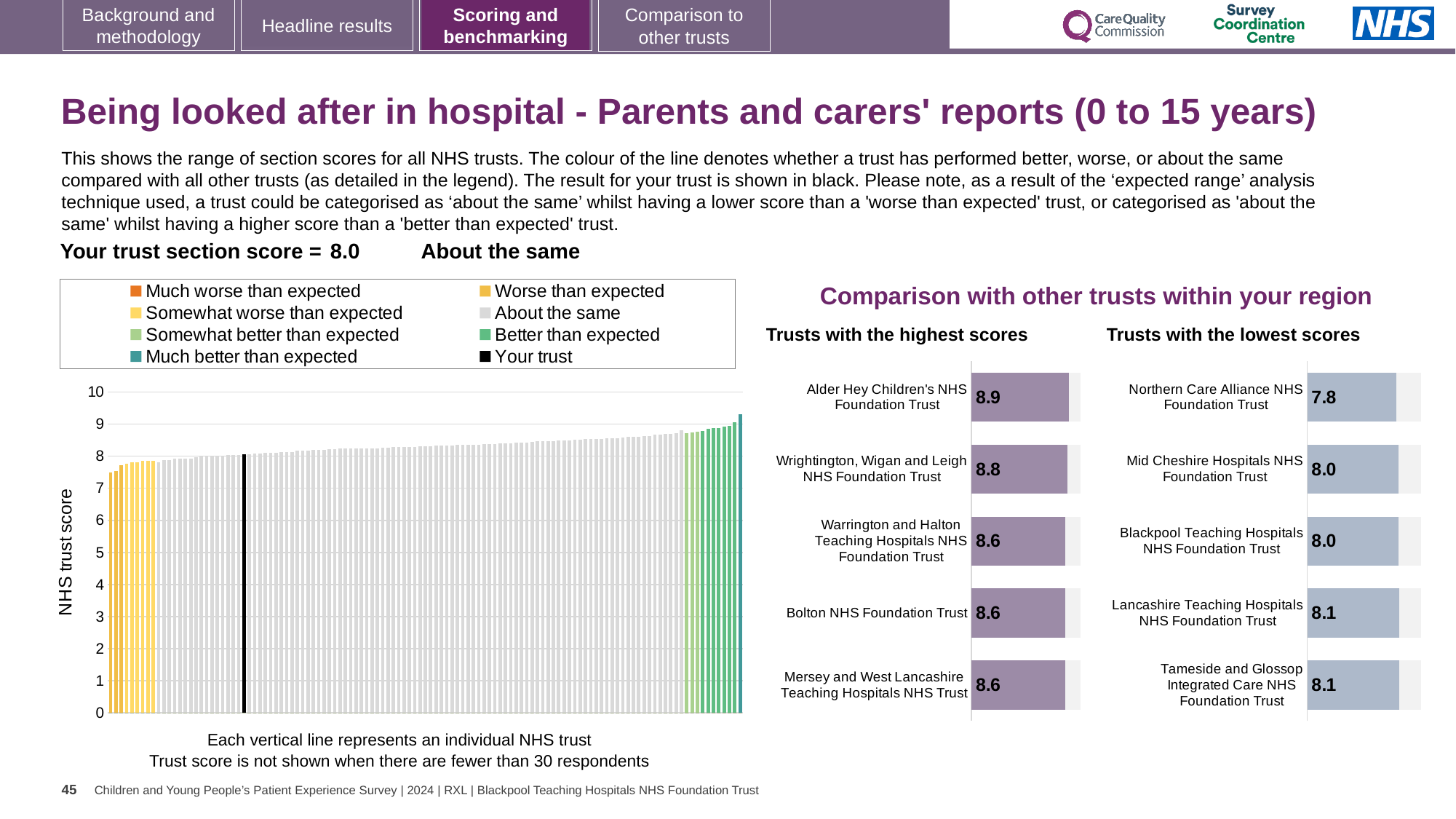
In the 'Trusts with the highest scores' chart, what is the difference between the scores of Alder Hey Children's NHS Foundation Trust and Bolton NHS Foundation Trust? 0.3 In the 'Trusts with the highest scores' chart, which trust has the highest score? Alder Hey Children's NHS Foundation Trust In the 'Trusts with the lowest scores' chart, what is the difference between the scores of Tameside and Glossop Integrated Care NHS Foundation Trust and Northern Care Alliance NHS Foundation Trust? 0.3 In the 'Trusts with the highest scores' chart, what is the score for Alder Hey Children's NHS Foundation Trust? 8.9 What kind of chart is the large chart on the left showing NHS trust scores? Bar chart In the large chart on the left, do the trust scores rise or fall from left to right? Rise How many trusts are shown in the 'Trusts with the highest scores' chart? 5 In the 'Trusts with the lowest scores' chart, what is the score for Northern Care Alliance NHS Foundation Trust? 7.8 In the 'Trusts with the lowest scores' chart, what is the score for Lancashire Teaching Hospitals NHS Foundation Trust? 8.1 In the 'Trusts with the lowest scores' chart, which has the larger score: Lancashire Teaching Hospitals NHS Foundation Trust or Northern Care Alliance NHS Foundation Trust? Lancashire Teaching Hospitals NHS Foundation Trust In the 'Trusts with the highest scores' chart, what is the score for Wrightington, Wigan and Leigh NHS Foundation Trust? 8.8 In the 'Trusts with the lowest scores' chart, which trust has the lowest score? Northern Care Alliance NHS Foundation Trust